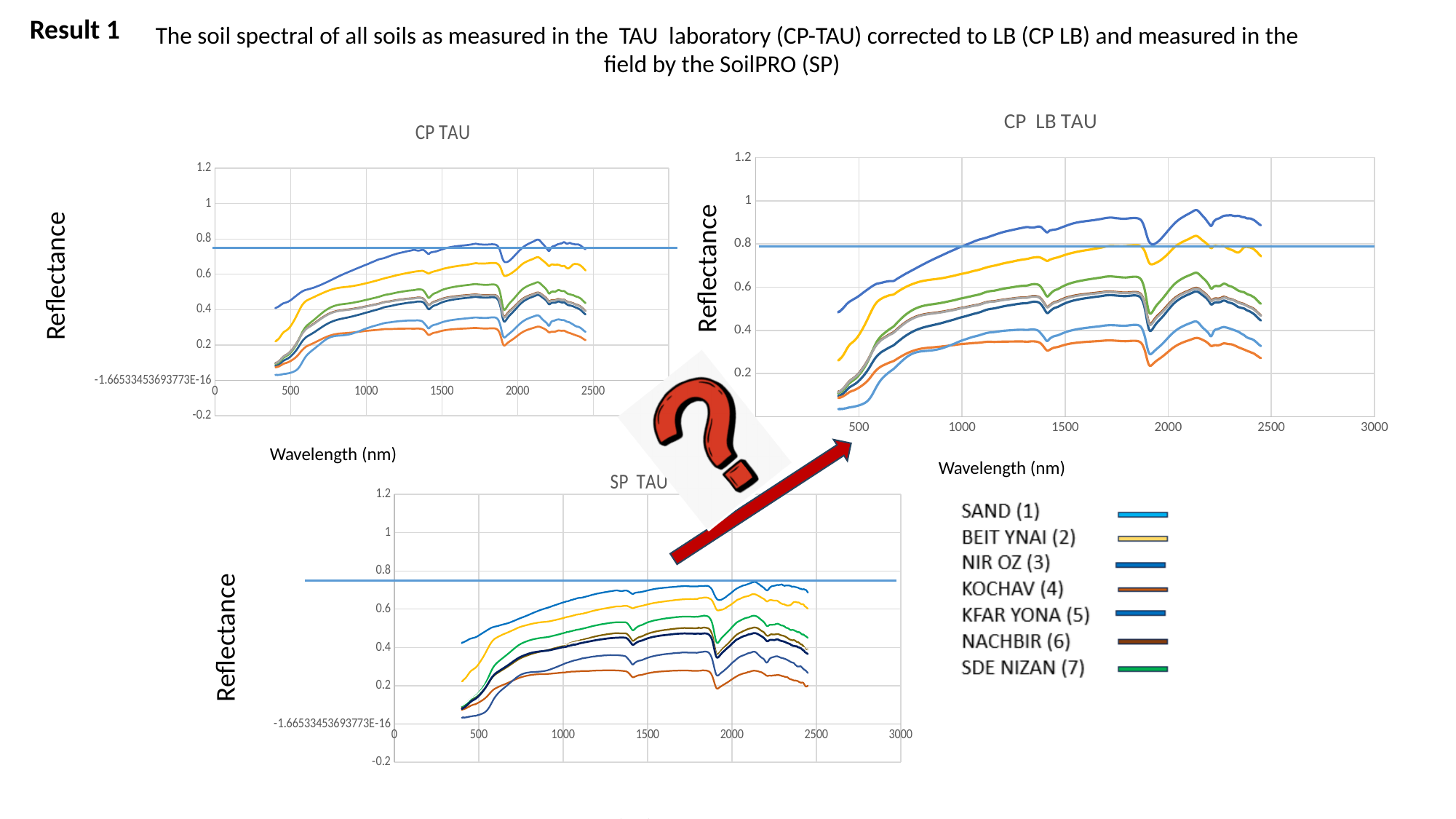
How many soils does the legend list? 7 In the CP LB TAU chart, is the value of the lowest curve at 1000 nm greater or less than 0.4? less In the SP TAU chart, do the curves generally rise or fall between 500 nm and 1500 nm? rise How many charts are shown on the slide? 3 In the SP TAU chart, is the value of the lowest curve at 1500 nm greater or less than 0.4? less What is the title of the chart in the top right of the slide? CP LB TAU What is the x-axis label of the charts? Wavelength (nm) In the CP TAU chart, is the value of the topmost curve at 1000 nm greater or less than 0.8? less What kind of chart is the CP TAU chart? line chart